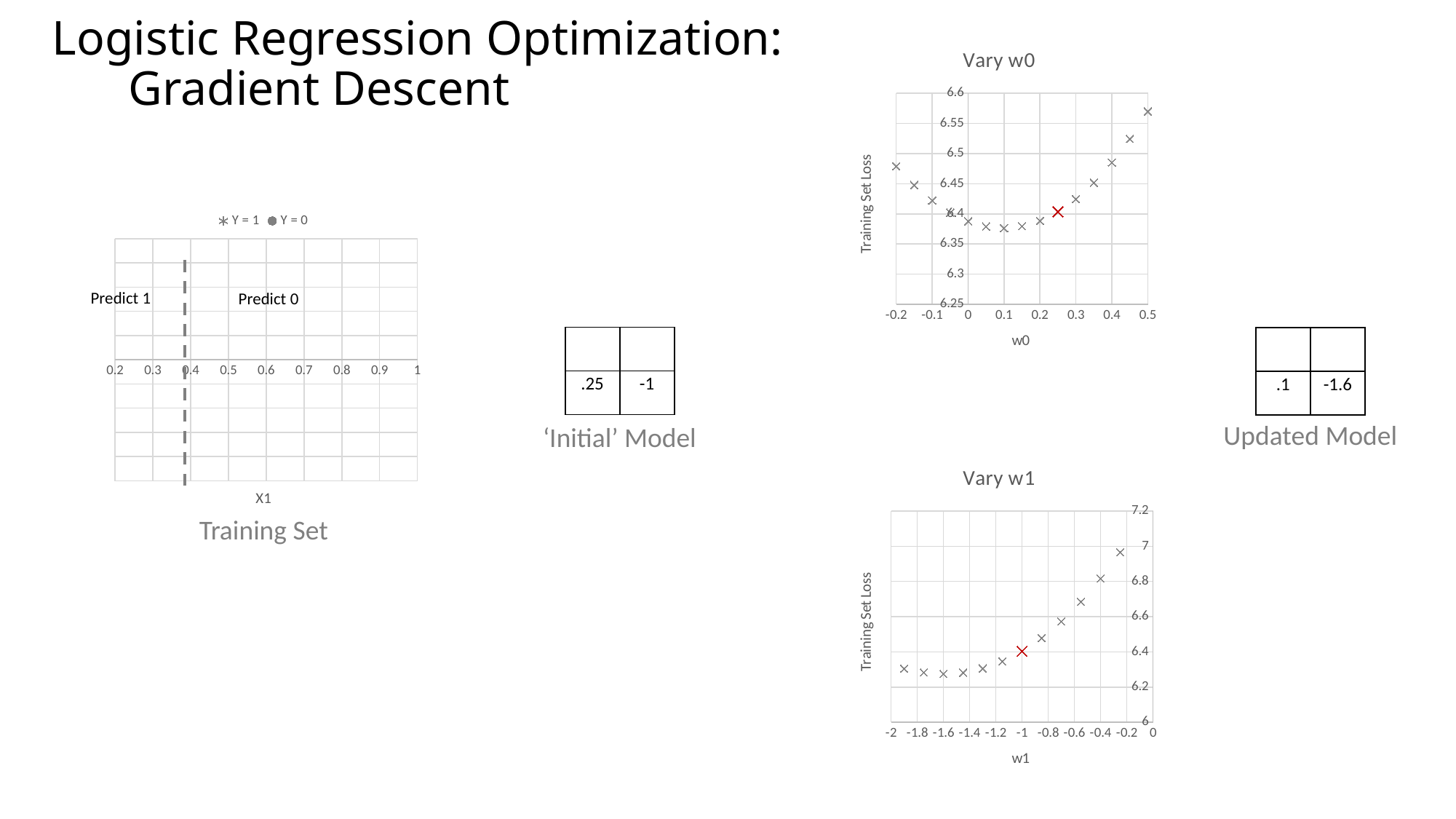
In the 'Vary w1' chart, is the training set loss at the rightmost point (near w1 = -0.2) greater or less than 6.8? greater In the 'Vary w0' chart, at which w0 value is the training set loss highest? 0.5 In the 'Vary w1' chart, which has the larger training set loss: the point near w1 = -0.4 or the point near w1 = -1.6? the point near w1 = -0.4 In the 'Vary w1' chart, does the training set loss rise or fall as w1 increases from -1 to 0? rise In the 'Vary w0' chart, is the training set loss at w0 = 0.5 greater or less than 6.55? greater In the 'Vary w0' chart, is the training set loss at w0 = 0.1 greater or less than 6.4? less What is the y-axis title of the 'Vary w0' chart? Training Set Loss What two legend entries does the 'Training Set' chart show? Y = 1 and Y = 0 In the 'Vary w0' chart, which has the larger training set loss: w0 = -0.2 or w0 = 0.5? w0 = 0.5 What kind of chart is the 'Vary w0' chart? scatter chart